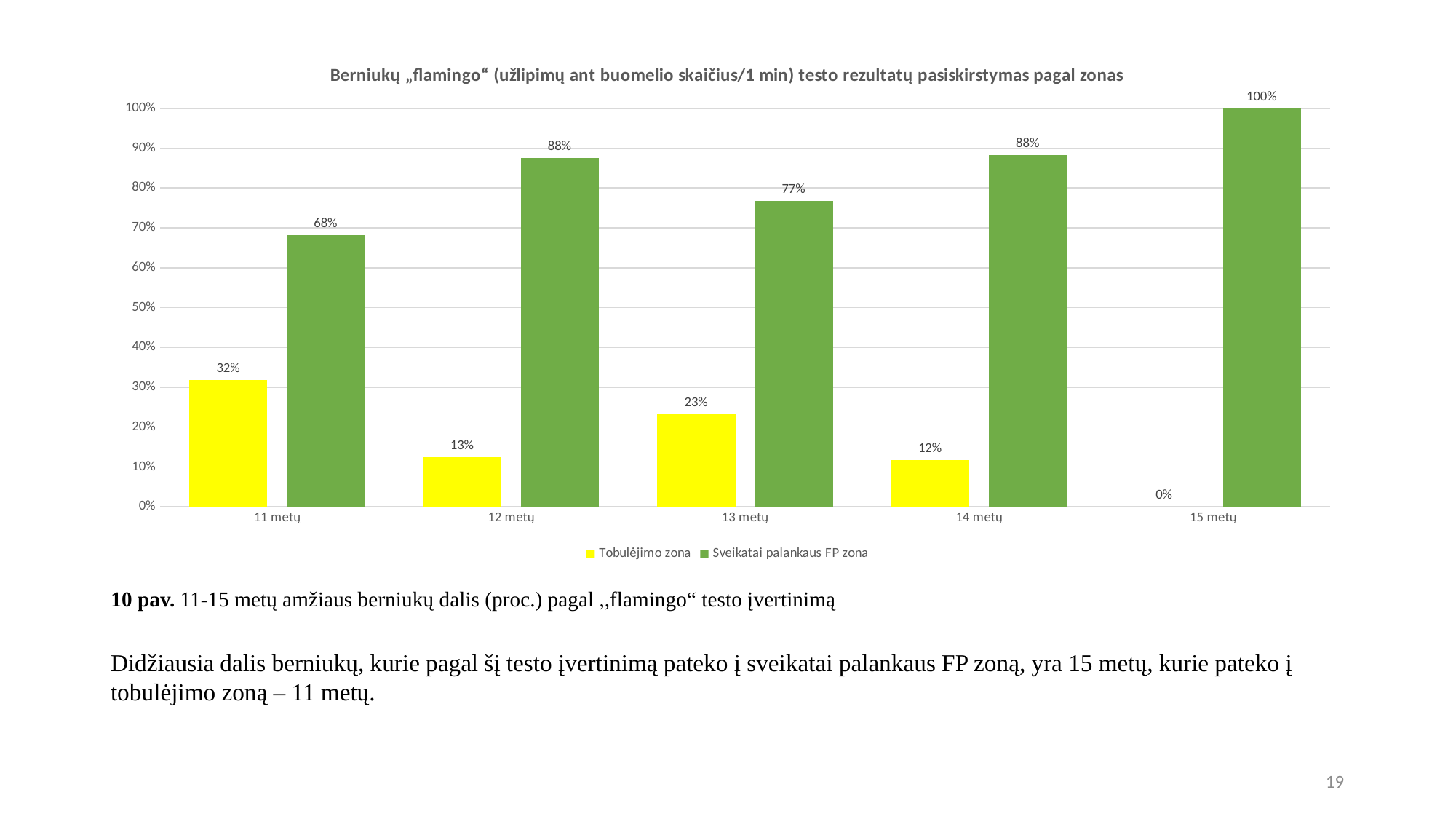
Which age group has the highest value for "Sveikatai palankaus FP zona"? 15 metų What kind of chart is shown on the slide? Bar chart What is the value for "Tobulėjimo zona" at 11 metų? 32% Which age group has the lowest value for "Tobulėjimo zona"? 15 metų Which is larger: the "Tobulėjimo zona" value at 11 metų or at 13 metų? 11 metų Does the "Tobulėjimo zona" series rise or fall from 14 metų to 15 metų? Fall What colour are the bars for "Sveikatai palankaus FP zona"? Green What is the difference between the "Sveikatai palankaus FP zona" value and the "Tobulėjimo zona" value at 12 metų? 75% What is the value for "Tobulėjimo zona" at 15 metų? 0% What is the value for "Sveikatai palankaus FP zona" at 13 metų? 77% How many age groups are shown on the x axis? 5 How many series does the legend list? 2